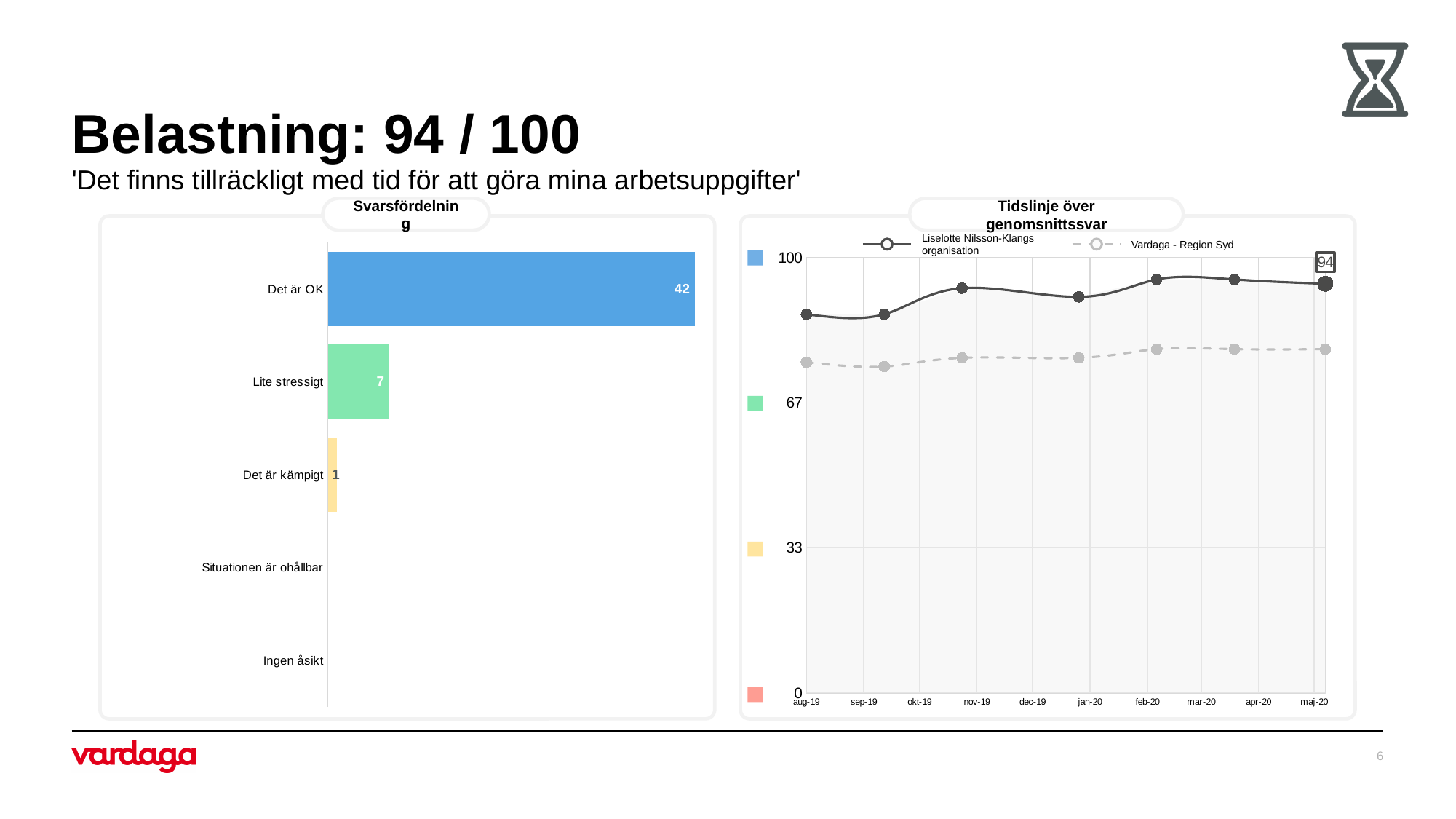
How many categories are listed in the Svarsfördelning chart? 5 What kind of chart is the Svarsfördelning chart? bar chart In the Svarsfördelning chart, what is the difference between the values for 'Det är OK' and 'Lite stressigt'? 35 How many series does the legend of the 'Tidslinje över genomsnittssvar' chart list? 2 In the Svarsfördelning chart, what is the value for 'Lite stressigt'? 7 In the Svarsfördelning chart, what is the value for 'Det är kämpigt'? 1 In the 'Tidslinje över genomsnittssvar' chart, which series is higher in maj-20? Liselotte Nilsson-Klangs organisation In the Svarsfördelning chart, which category has the highest value? Det är OK In the 'Tidslinje över genomsnittssvar' chart, what is the value for 'Liselotte Nilsson-Klangs organisation' in maj-20? 94 In the 'Tidslinje över genomsnittssvar' chart, is the value for 'Vardaga - Region Syd' in maj-20 greater or less than 67? greater In the Svarsfördelning chart, what is the value for 'Det är OK'? 42 In the Svarsfördelning chart, which is larger: 'Lite stressigt' or 'Det är kämpigt'? Lite stressigt